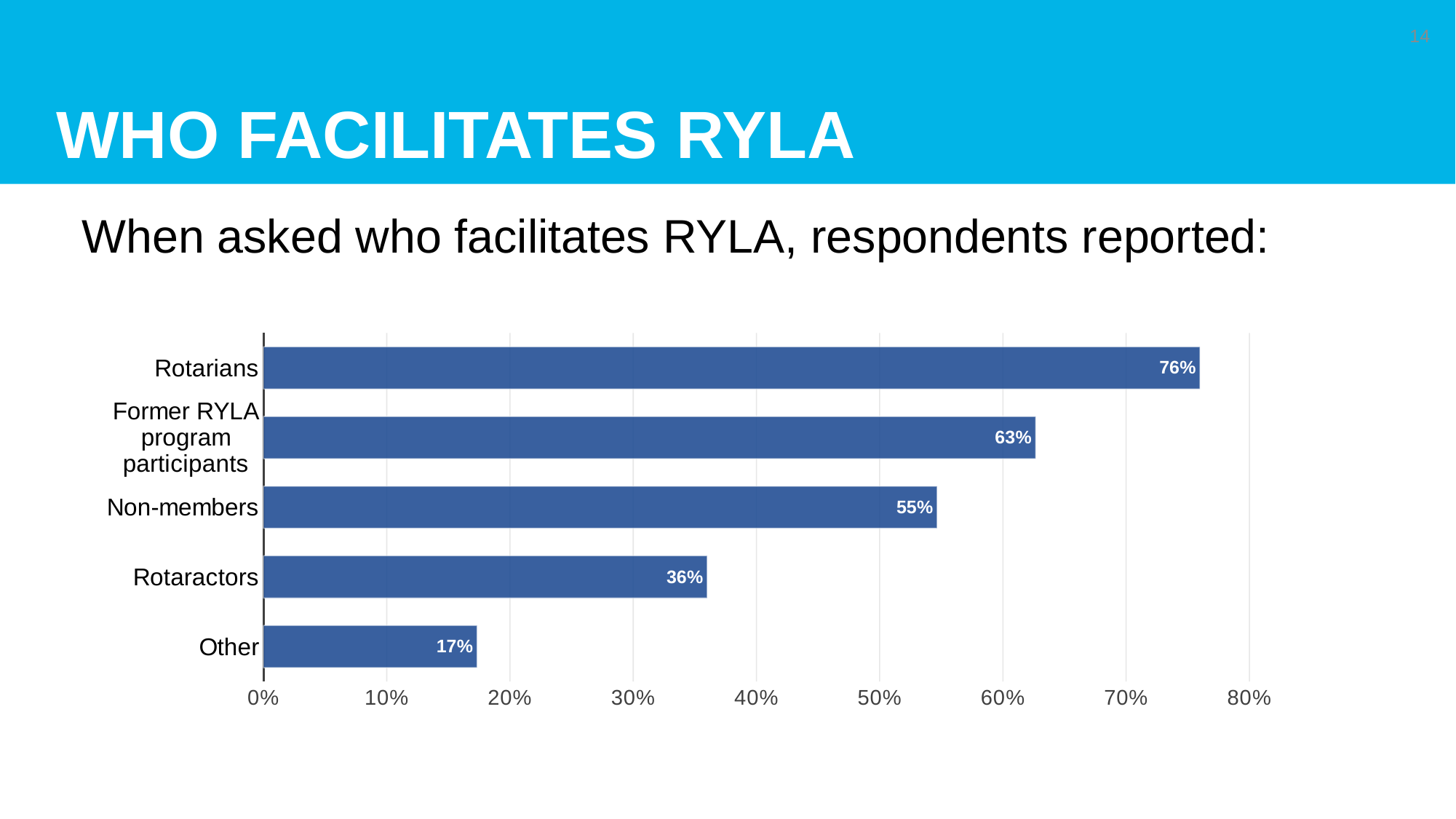
Which is larger, the value for Non-members or the value for Former RYLA program participants? Former RYLA program participants What is the value for Former RYLA program participants? 63% What is the difference between the values for Rotarians and Rotaractors? 40% What is the value for Other? 17% What is the highest tick label shown on the horizontal axis? 80% What is the value for Non-members? 55% What kind of chart is shown on the slide? Bar chart How many categories are shown in the chart? 5 Which category has the highest value? Rotarians What percentage of respondents reported that Rotarians facilitate RYLA? 76% What is the value for Rotaractors? 36% Which category has the lowest value? Other